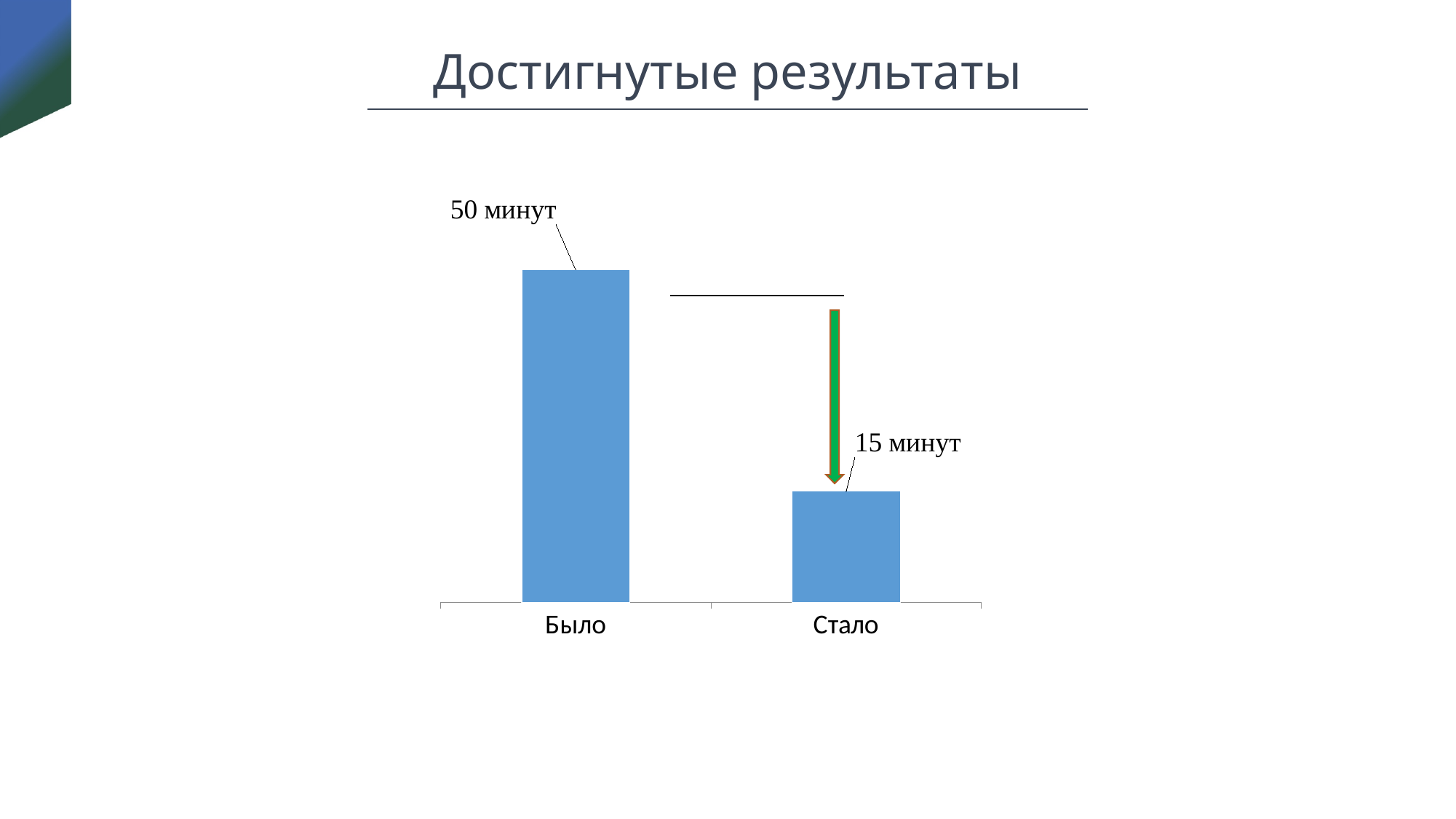
Do the values rise or fall from Было to Стало? fall How many categories are shown on the x axis? 2 What is the title of the slide above the chart? Достигнутые результаты What is the value for Было? 50 минут Which category has the lowest value? Стало What colour are the bars in the chart? blue What is the difference between the values for Было and Стало? 35 минут Which category has the highest value? Было What kind of chart is shown on the slide? bar chart Which is larger, the value for Было or the value for Стало? Было What is the value for Стало? 15 минут